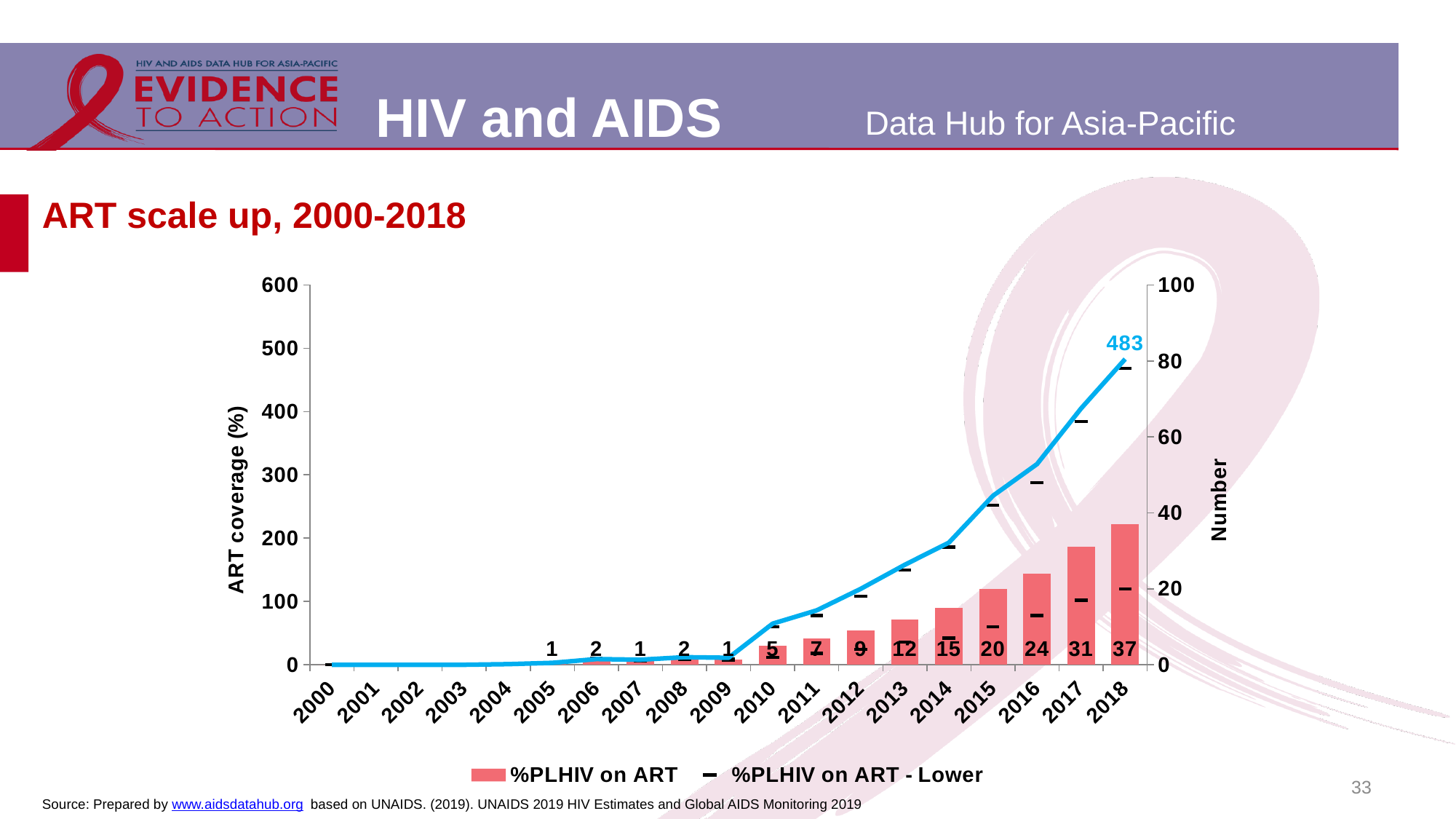
Which year has a higher %PLHIV on ART value, 2016 or 2013? 2016 Do the %PLHIV on ART values rise or fall from 2010 to 2018? Rise What is the title of the chart? ART scale up, 2000-2018 How many years are shown on the x axis? 19 What value is labelled on the blue Number line for 2018? 483 What kind of chart is shown on the slide? Combined bar and line chart Is the blue Number line value for 2017 greater or less than 300 on the left axis? greater What is the %PLHIV on ART value for 2018? 37 How many series does the legend list? 2 What is the difference between the %PLHIV on ART values for 2018 and 2017? 6 Which year has the highest %PLHIV on ART bar? 2018 What is the %PLHIV on ART value for 2015? 20